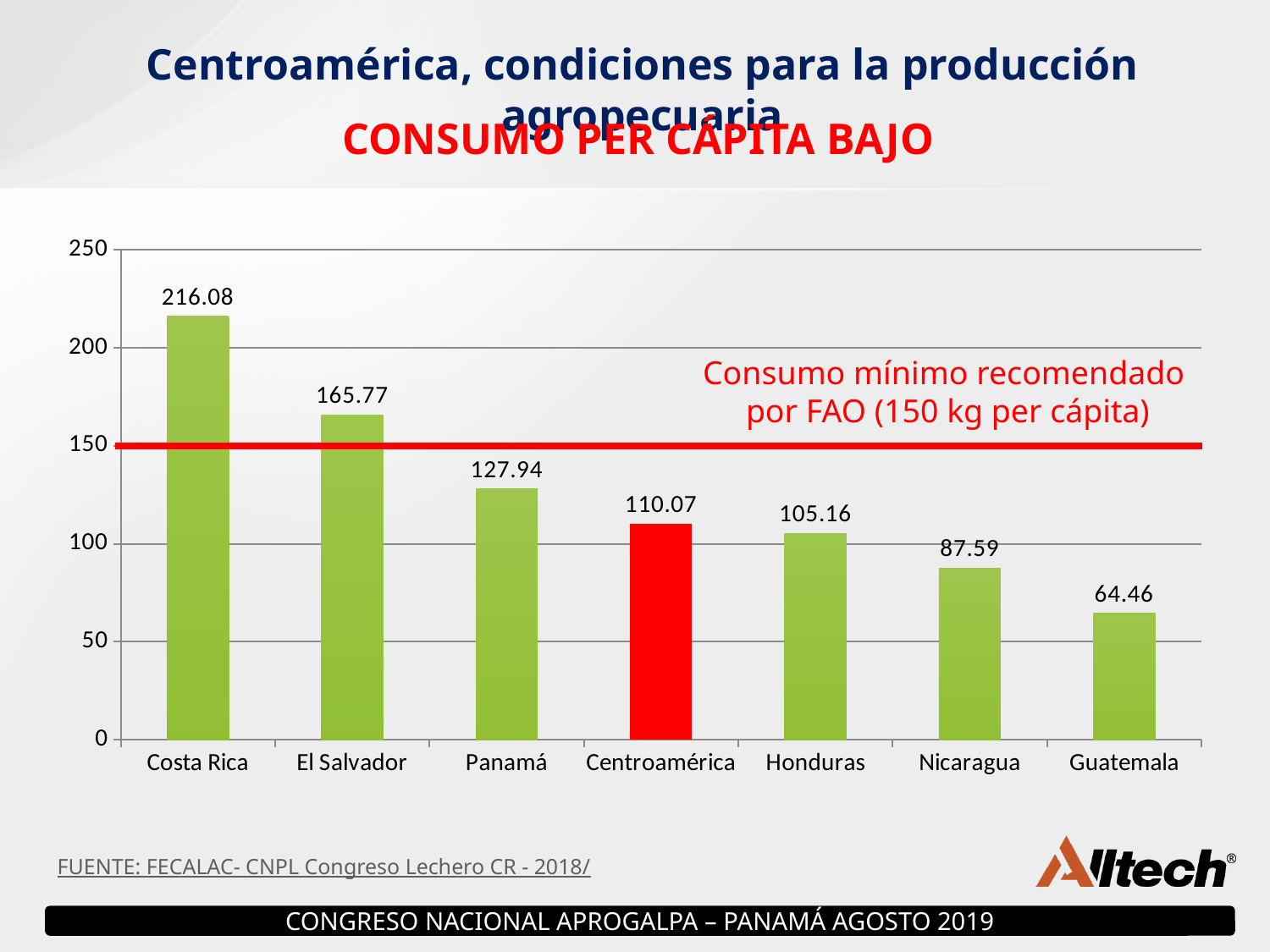
Which category has the lowest value? Guatemala What kind of chart is shown on the slide? bar chart What is the value for Costa Rica? 216.08 What is the value for Guatemala? 64.46 Do the values rise or fall from left to right along the x axis? fall What is the difference between the values for Costa Rica and El Salvador? 50.31 How many categories are shown on the x axis? 7 What is the value for Honduras? 105.16 Which is larger, the value for Panamá or the value for Nicaragua? Panamá Which bar is coloured red instead of green? Centroamérica Is the value for Centroamérica greater or less than 150? less Which category has the highest value? Costa Rica